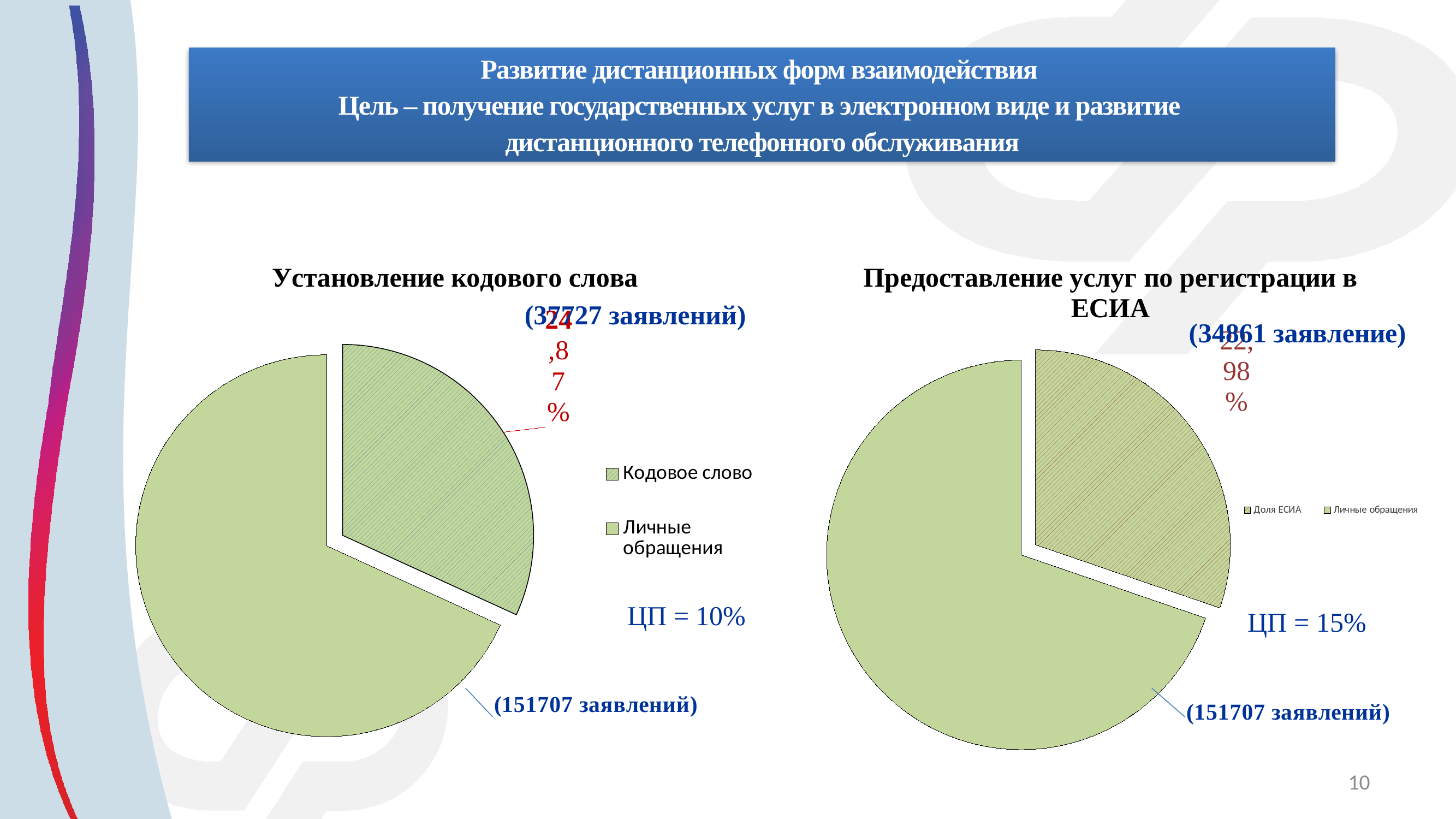
What kind of chart is the right chart titled "Предоставление услуг по регистрации в ЕСИА"? pie chart In the right chart "Предоставление услуг по регистрации в ЕСИА", which slice is the smallest? Доля ЕСИА What are the two legend entries of the right chart "Предоставление услуг по регистрации в ЕСИА"? Доля ЕСИА, Личные обращения In the left chart "Установление кодового слова", which slice is larger: "Кодовое слово" or "Личные обращения"? Личные обращения In the left chart "Установление кодового слова", how many applications are shown next to the "Личные обращения" slice? 151707 заявлений In the right chart "Предоставление услуг по регистрации в ЕСИА", which slice is the largest? Личные обращения What is the title of the left pie chart? Установление кодового слова In the left chart "Установление кодового слова", how many slices does the pie have? 2 In the right chart "Предоставление услуг по регистрации в ЕСИА", how many entries does the legend list? 2 In the left chart "Установление кодового слова", what percentage is shown for the "Кодовое слово" slice? 24,87% In the left chart "Установление кодового слова", how many entries does the legend list? 2 What kind of chart is the left chart titled "Установление кодового слова"? pie chart